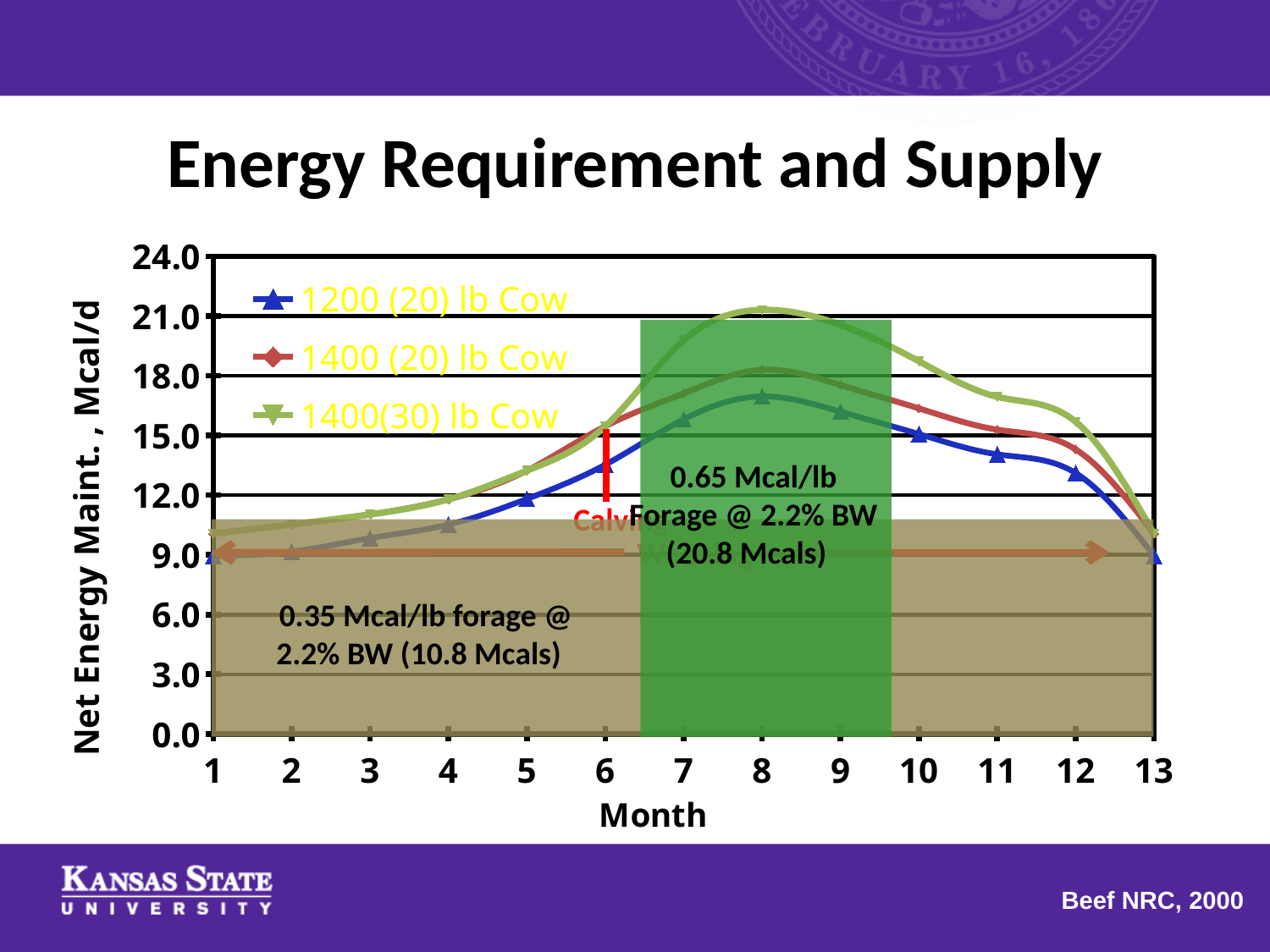
How many series does the legend list? 3 What kind of chart is shown on the slide? line chart Is the value for the 1200 (20) lb Cow series at month 4 greater or less than 12.0? less What is the title of the chart? Energy Requirement and Supply Is the value for the 1200 (20) lb Cow series at month 8 greater or less than 15.0? greater Is the value for the 1400(30) lb Cow series at month 8 greater or less than 18.0? greater Which series has the highest value at month 8? 1400(30) lb Cow According to the annotation on the chart, how many Mcals does 0.65 Mcal/lb forage at 2.2% BW supply? 20.8 Mcals How many months are marked along the x axis? 13 Does the 1200 (20) lb Cow series rise or fall from month 8 to month 13? fall At which month does the 1400(30) lb Cow series reach its highest value? 8 At month 8, which is larger: the 1400(30) lb Cow value or the 1200 (20) lb Cow value? 1400(30) lb Cow